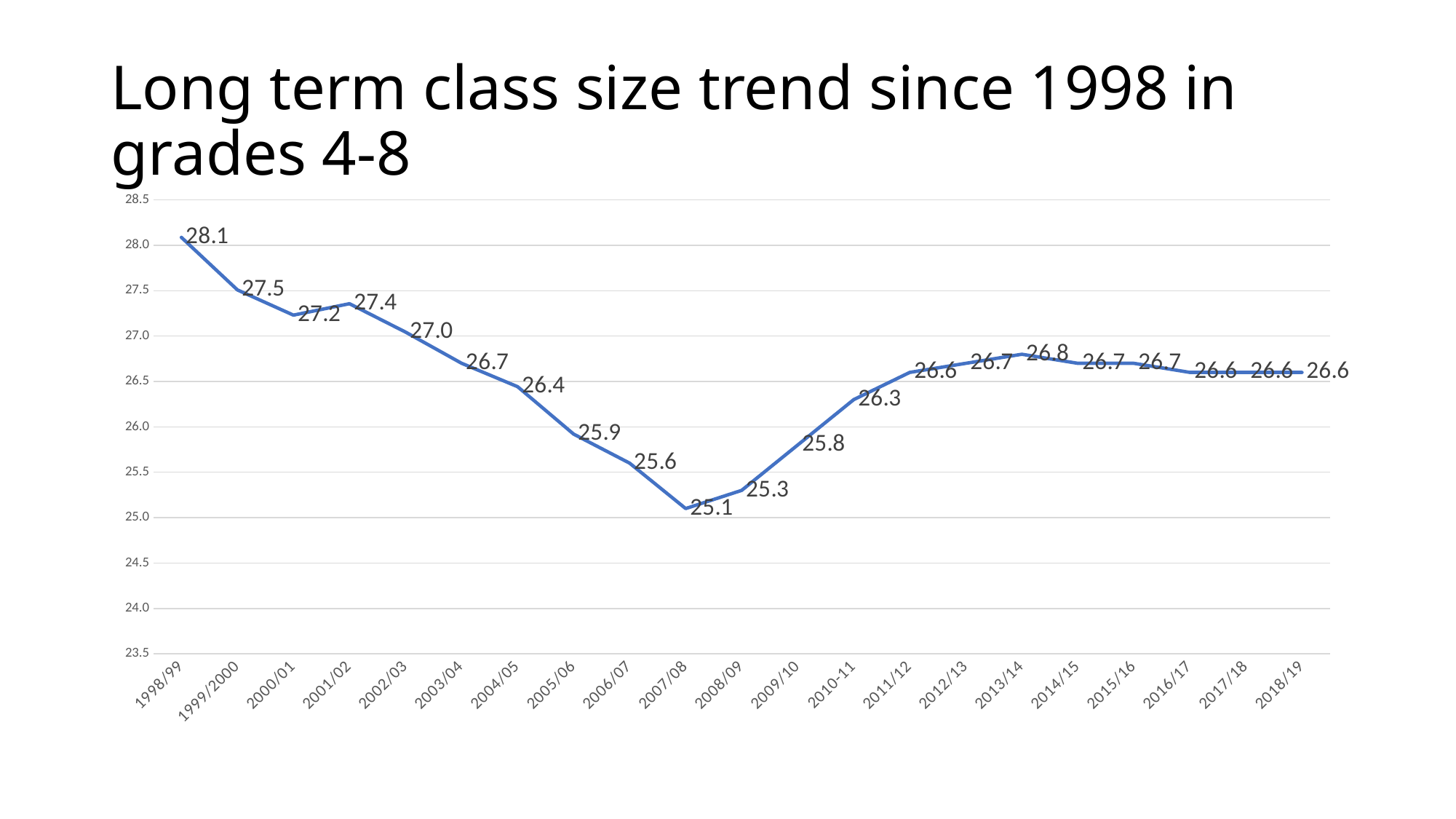
What is the class size value for 2007/08? 25.1 What is the class size value for 2013/14? 26.8 How many school years are plotted on the chart? 21 What is the class size value for 2018/19? 26.6 Do the values rise or fall from 1998/99 to 2007/08? fall Is the value for 2005/06 greater or less than 26.0? less Which school year has the highest class size? 1998/99 What kind of chart is shown on the slide? line chart Which is larger, the class size in 2001/02 or in 2004/05? 2001/02 What is the class size value for 1998/99? 28.1 Which school year has the lowest class size? 2007/08 What is the difference between the class size in 1998/99 and in 2007/08? 3.0